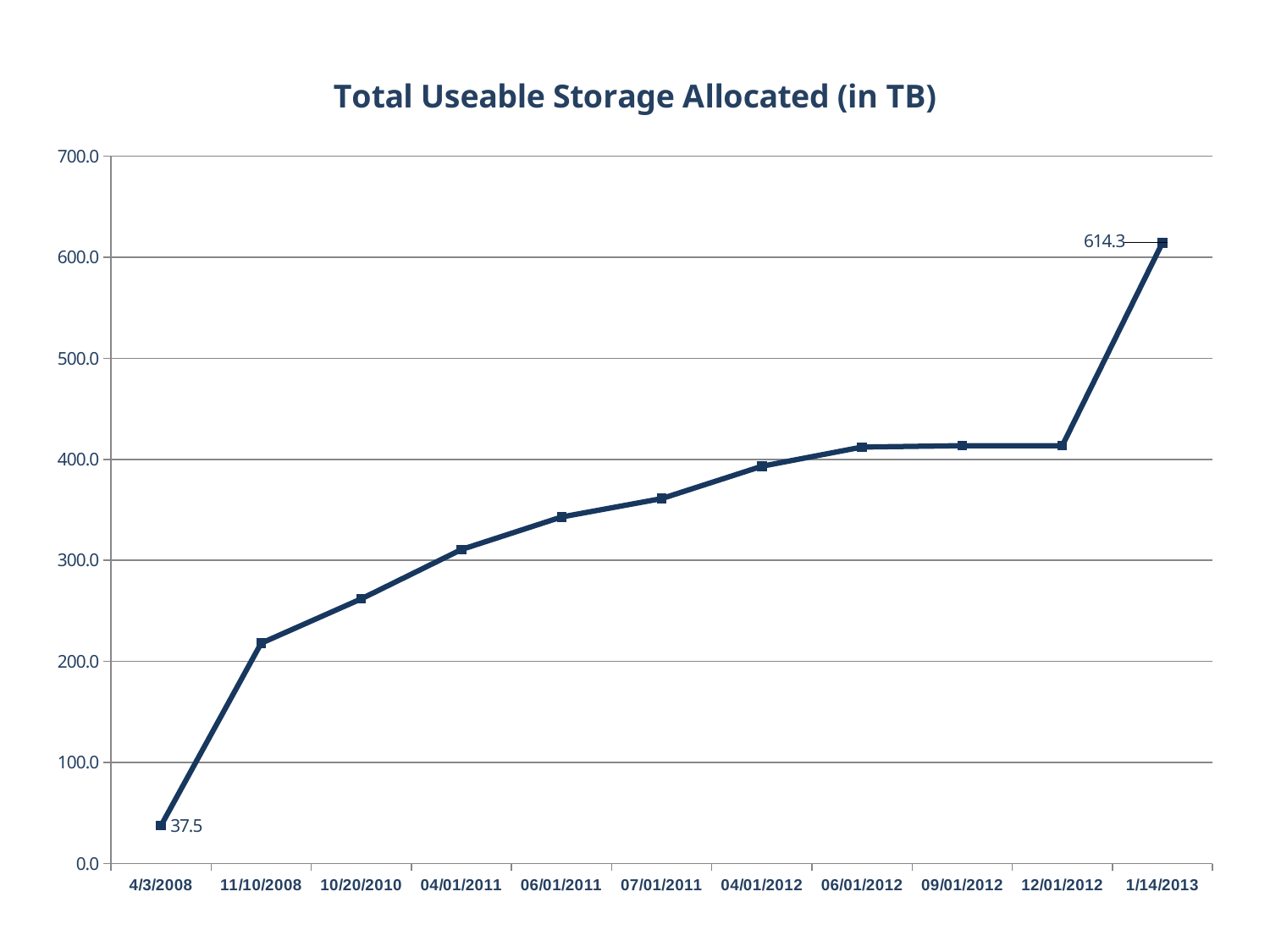
Is the value for 11/10/2008 greater or less than 200? greater What is the value for 1/14/2013? 614.3 What is the value for 4/3/2008? 37.5 What type of chart is shown on the slide? Line chart Is the value for 10/20/2010 greater or less than 300? less What is the title of the chart? Total Useable Storage Allocated (in TB) What is the difference between the values for 1/14/2013 and 4/3/2008? 576.8 How many data points are plotted on the chart? 11 Which date has the highest value? 1/14/2013 Which date has the lowest value? 4/3/2008 Is the value for 06/01/2012 greater or less than 400? greater Do the values generally rise or fall from 4/3/2008 to 1/14/2013? Rise